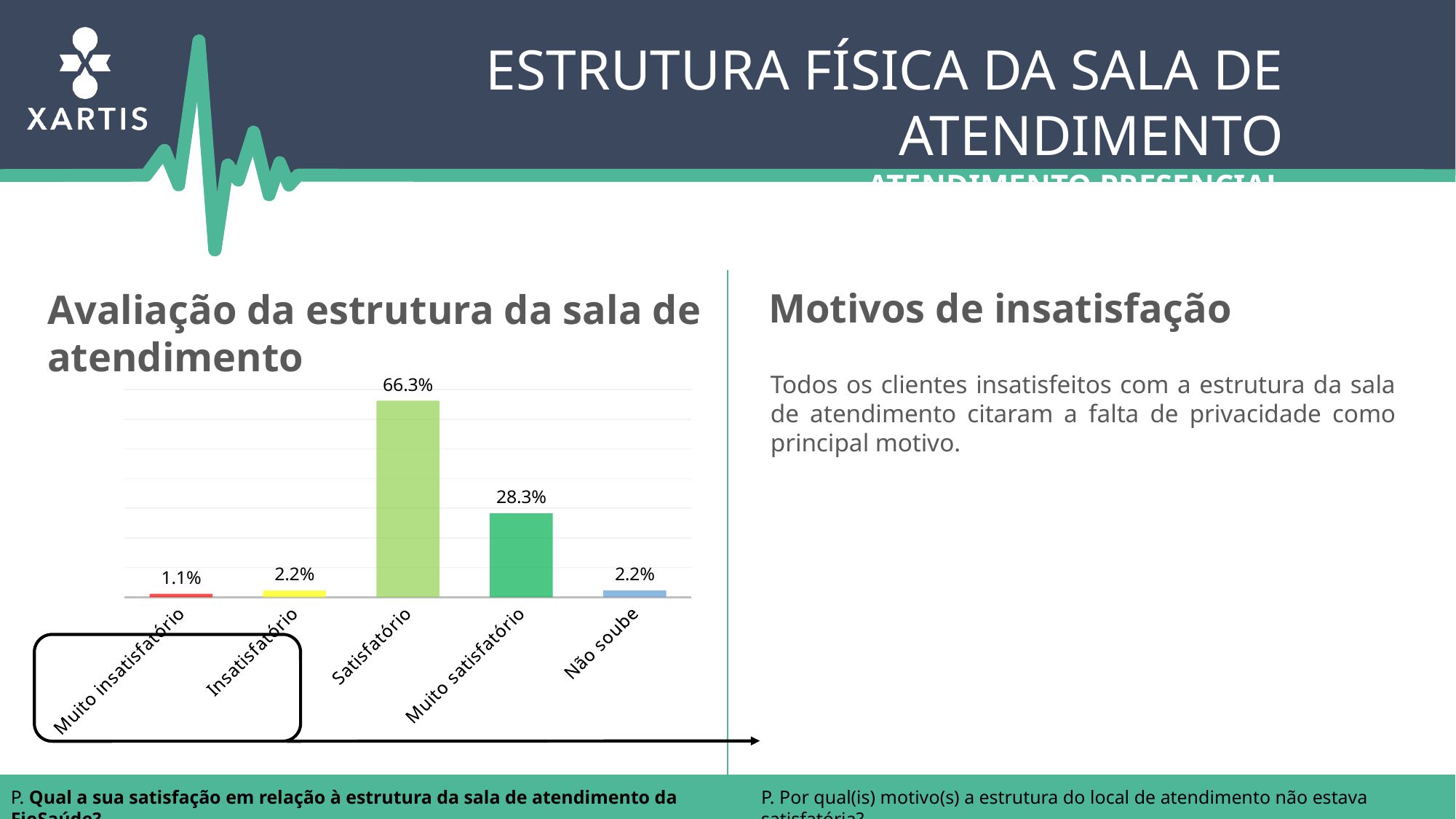
Which is larger, the value for Insatisfatório or the value for Muito insatisfatório? Insatisfatório What is the title of the chart on the left of the slide? Avaliação da estrutura da sala de atendimento Which category has the lowest value? Muito insatisfatório What is the value for Satisfatório? 66.3% What kind of chart is shown on the slide? Bar chart What is the value for Muito satisfatório? 28.3% What is the value for Muito insatisfatório? 1.1% What is the combined value of Muito insatisfatório and Insatisfatório? 3.3% What is the difference between the values for Satisfatório and Muito satisfatório? 38.0% Which category has the highest value? Satisfatório What is the value for Não soube? 2.2% How many categories are shown on the chart? 5